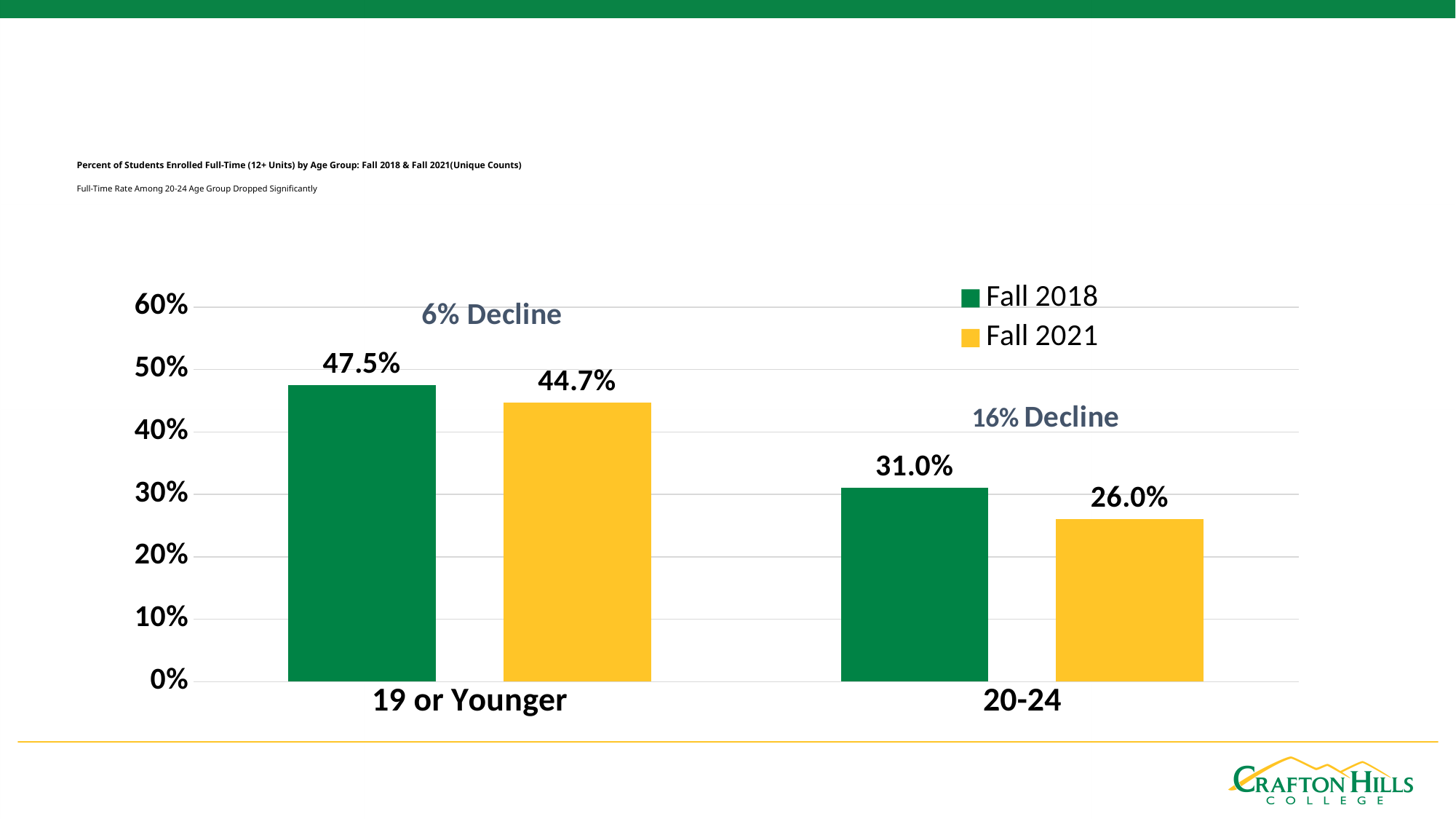
Which age group has the lowest Fall 2021 value? 20-24 What is the Fall 2018 value for the 19 or Younger age group? 47.5% What is the Fall 2021 value for the 19 or Younger age group? 44.7% Which age group has the highest Fall 2018 value? 19 or Younger What is the Fall 2018 value for the 20-24 age group? 31.0% Which is larger for the 19 or Younger age group: the Fall 2018 value or the Fall 2021 value? Fall 2018 What is the Fall 2021 value for the 20-24 age group? 26.0% What colour represents Fall 2021 in the legend? Yellow How many series does the legend list? 2 How many age groups are shown on the x axis? 2 What kind of chart is shown on the slide? Bar chart What is the difference between the Fall 2018 and Fall 2021 values for the 20-24 age group? 5.0%